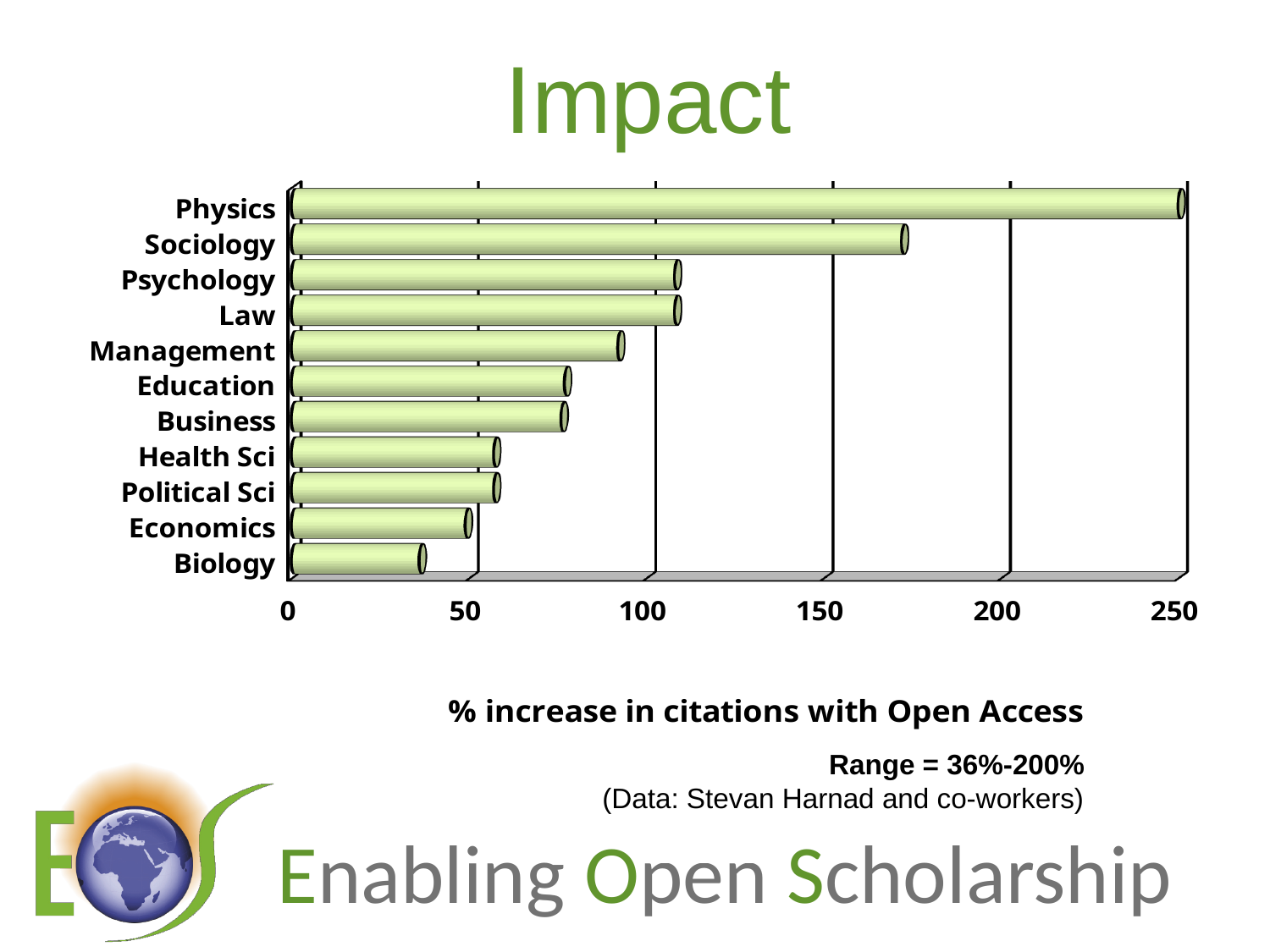
Which discipline has the lowest % increase in citations with Open Access? Biology Which discipline has the highest % increase in citations with Open Access? Physics Is the value for Psychology greater or less than 100? greater Which has a larger value, Management or Education? Management Is the value for Biology greater or less than 50? less What quantity does the chart measure, according to the caption below it? % increase in citations with Open Access How many disciplines are plotted in the chart? 11 Which has a larger value, Sociology or Psychology? Sociology Is the value for Management greater or less than 100? less What kind of chart is shown on the slide? bar chart